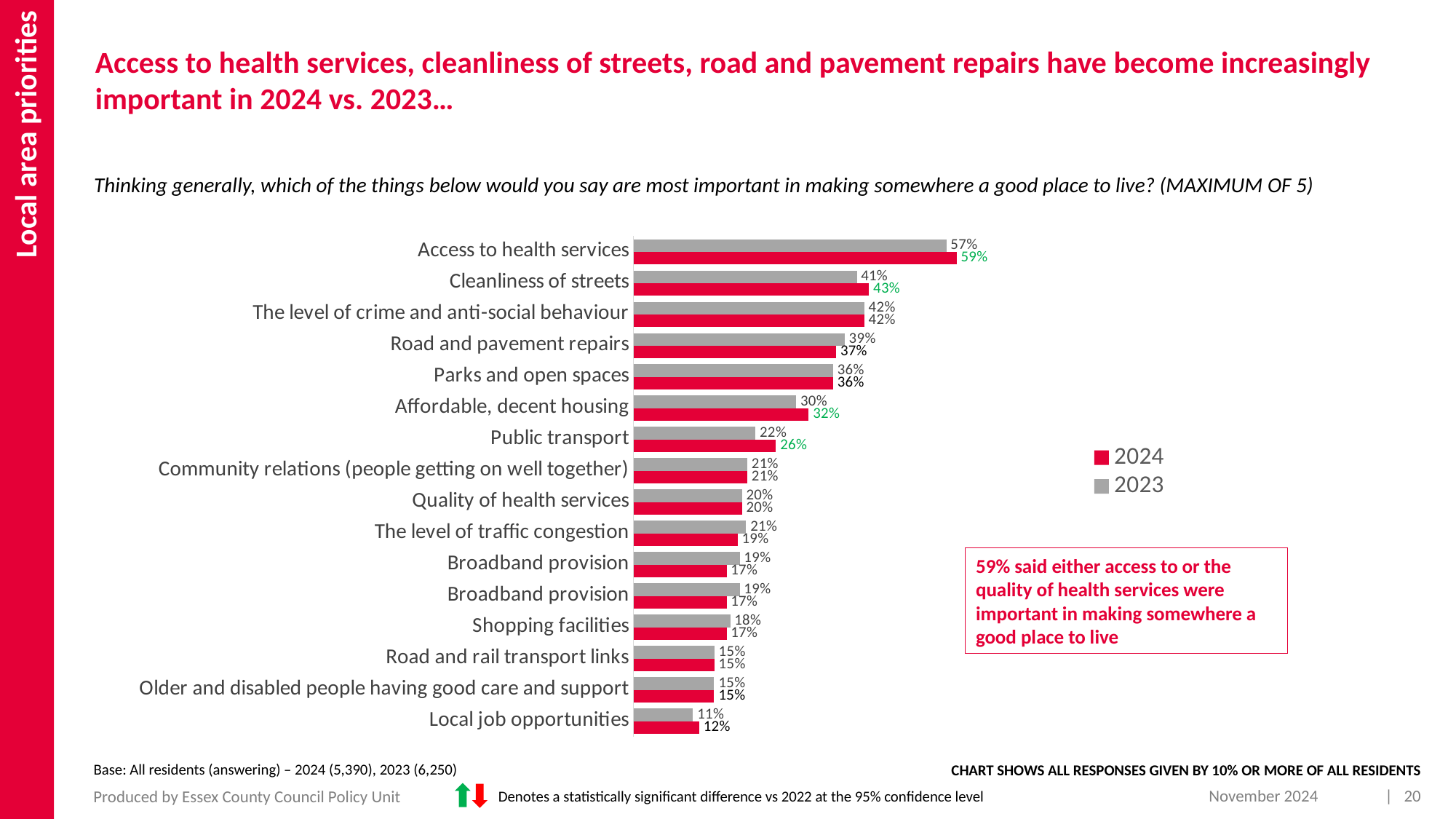
What is the 2023 value for Road and pavement repairs? 39% Which category has the lowest 2023 value? Local job opportunities How many categories are shown on the chart? 16 What is the 2023 value for Cleanliness of streets? 41% Which category has the highest 2024 value? Access to health services Which is larger for Affordable, decent housing: the 2024 value or the 2023 value? 2024 What kind of chart is shown on the slide? Bar chart What is the difference between the 2024 and 2023 values for Public transport? 4% What is the 2024 value for Public transport? 26% Which colour represents the 2023 series in the legend? Grey How many series does the legend list? 2 What is the 2024 value for Access to health services? 59%